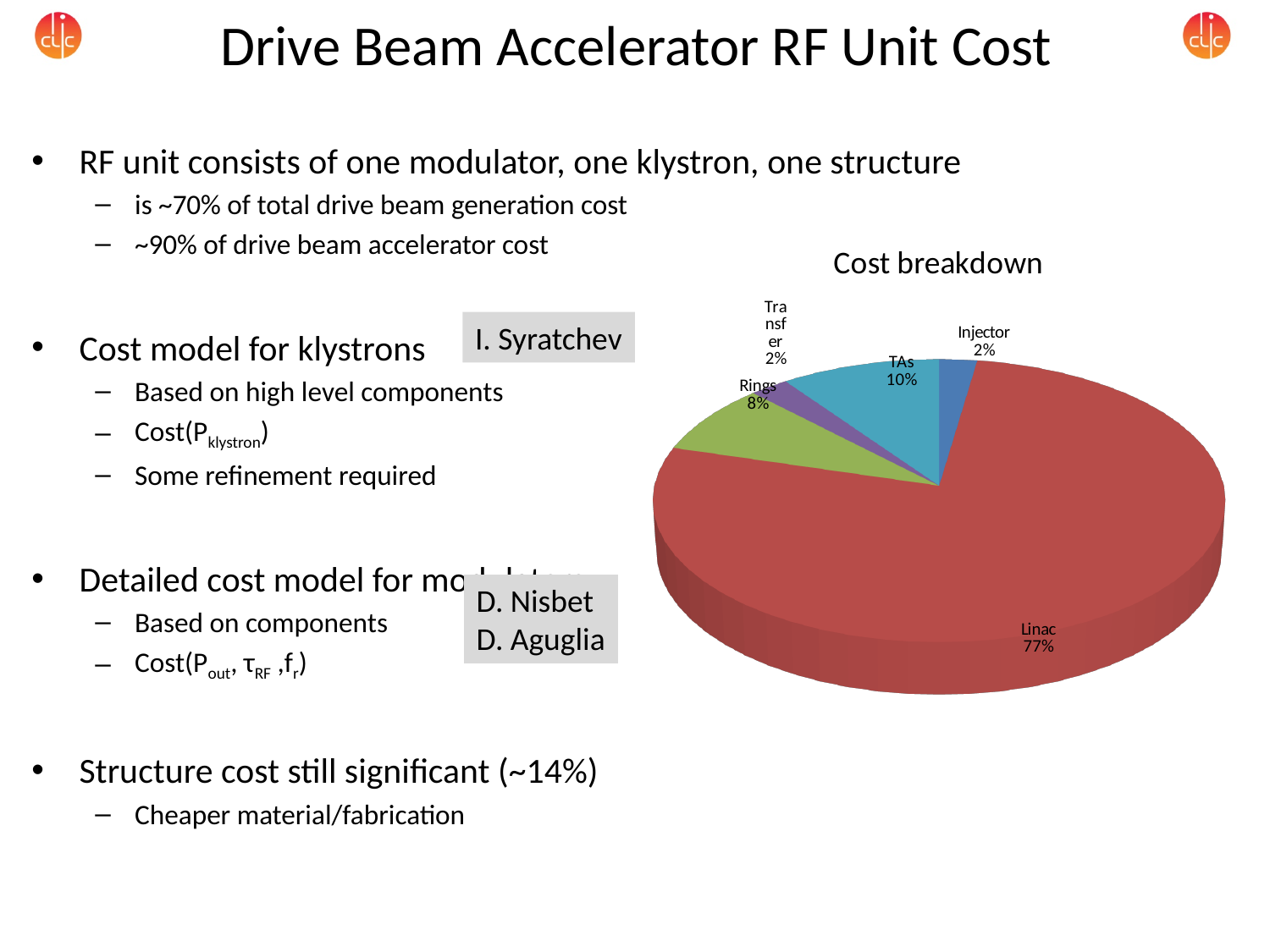
What percentage is shown for Transfer in the Cost breakdown chart? 2% What is the title of the pie chart on the slide? Cost breakdown What is the difference in percentage points between Linac and TAs in the Cost breakdown chart? 67 How many slices does the Cost breakdown pie chart have? 5 What type of chart is the Cost breakdown chart? Pie chart What is the difference in percentage points between TAs and Rings in the Cost breakdown chart? 2 In the Cost breakdown chart, which is larger, TAs or Rings? TAs What percentage is shown for TAs in the Cost breakdown chart? 10% What percentage is shown for Rings in the Cost breakdown chart? 8% What percentage is shown for Injector in the Cost breakdown chart? 2% Which category has the largest slice in the Cost breakdown chart? Linac What share of the Cost breakdown pie chart does Linac account for? 77%